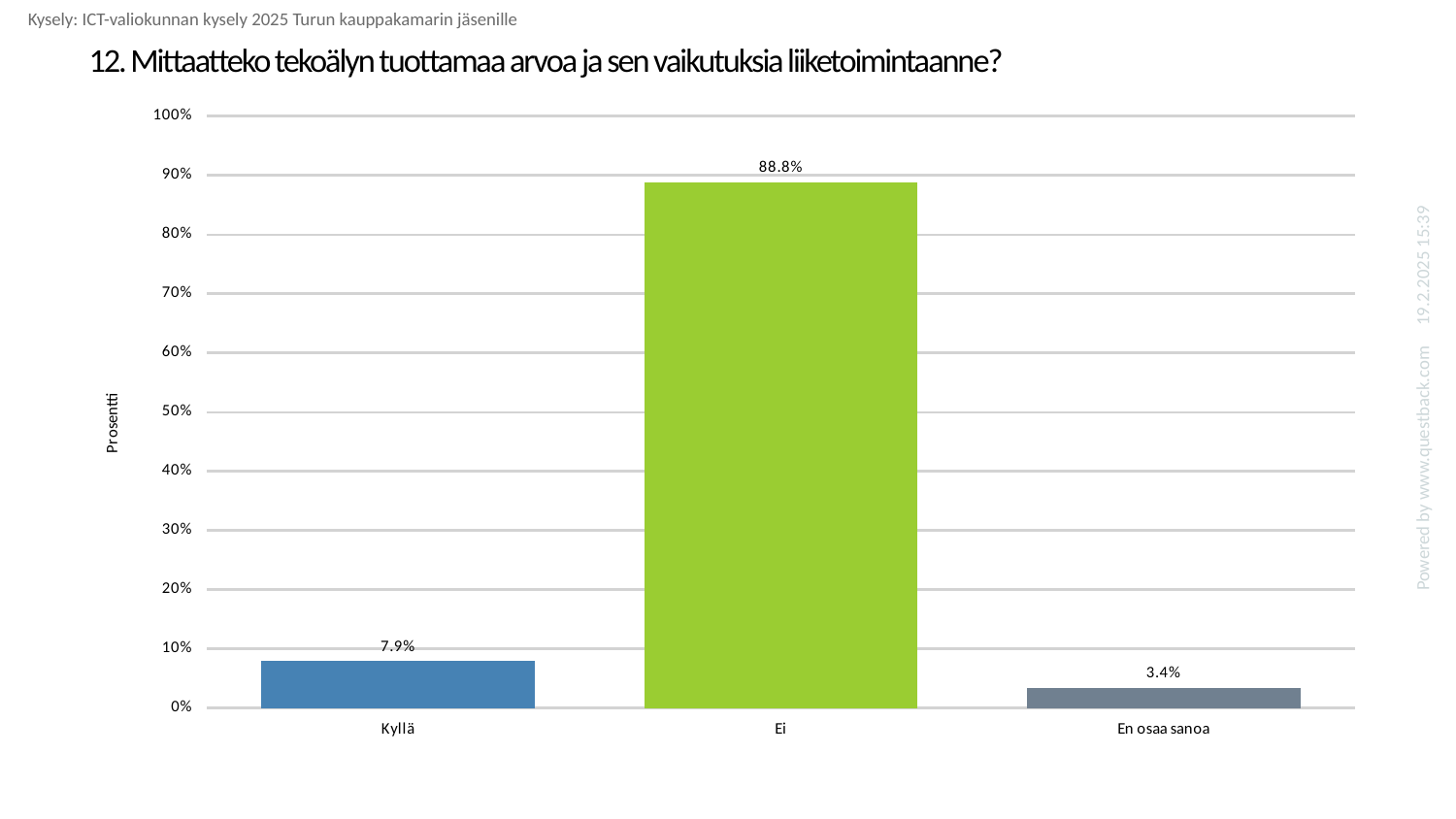
What is the difference between the values for "Ei" and "Kyllä"? 80.9% What kind of chart is shown on the slide? bar chart How many categories are shown on the x axis? 3 Which category has the highest value? Ei Which is larger, the value for "Kyllä" or the value for "En osaa sanoa"? Kyllä What is the value for "En osaa sanoa"? 3.4% What is the label of the y axis? Prosentti What is the difference between the values for "Kyllä" and "En osaa sanoa"? 4.5% What is the value for "Ei"? 88.8% Which category has the lowest value? En osaa sanoa What is the value for "Kyllä"? 7.9% Is the value for "Ei" greater or less than 80%? greater